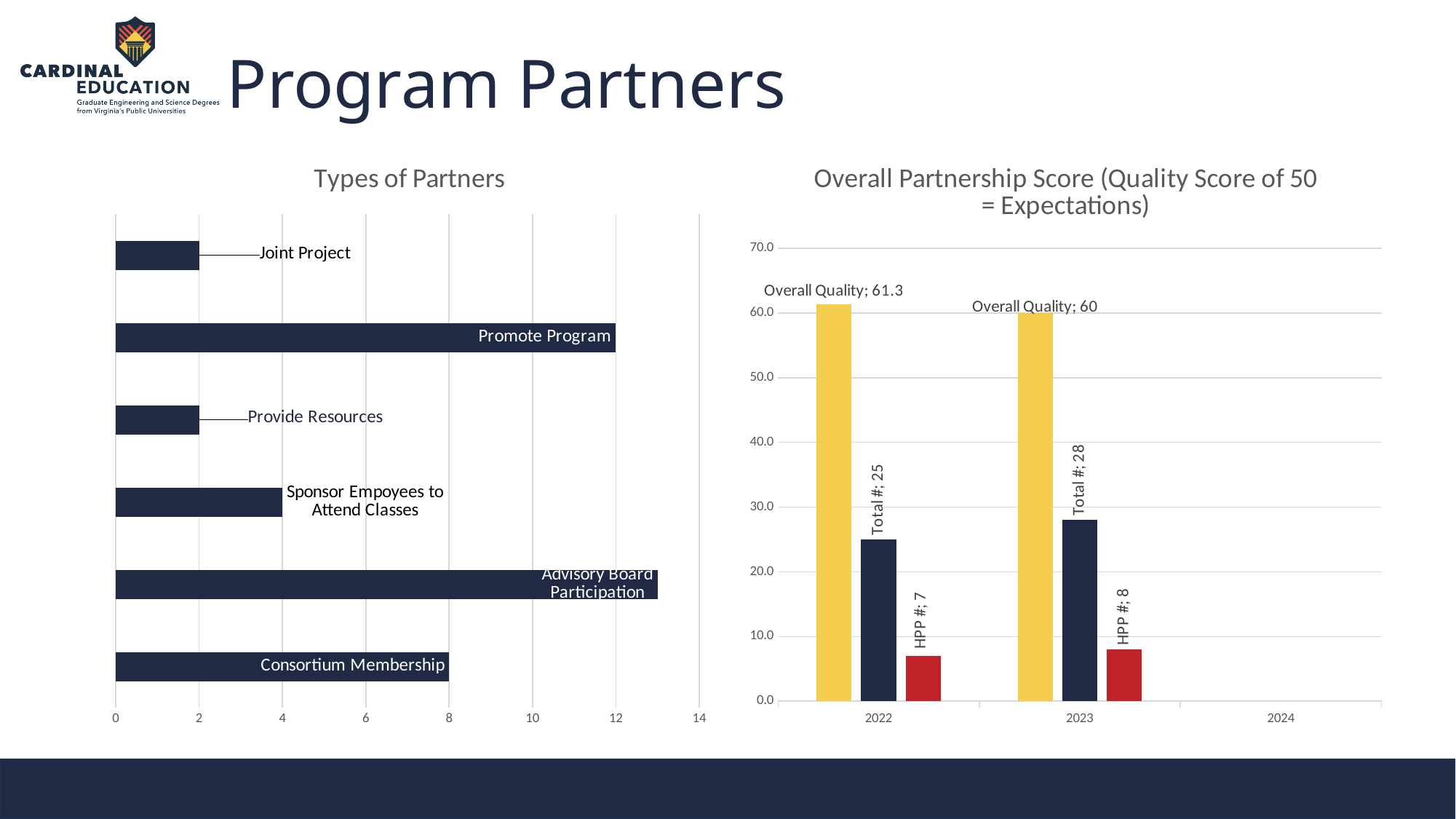
In the "Types of Partners" chart, what is the value for Consortium Membership? 8 In the "Overall Partnership Score" chart, what is the Overall Quality value for 2022? 61.3 In the "Overall Partnership Score" chart, what is the Total # for 2023? 28 In the "Types of Partners" chart, which type of partner has the highest value? Advisory Board Participation In the "Types of Partners" chart, which is larger: Sponsor Employees to Attend Classes or Provide Resources? Sponsor Employees to Attend Classes In the "Overall Partnership Score" chart, does the Overall Quality rise or fall from 2022 to 2023? fall What kind of chart is the "Types of Partners" chart? bar chart In the "Types of Partners" chart, what is the value for Promote Program? 12 In the "Overall Partnership Score" chart, by how much did the Total # increase from 2022 to 2023? 3 In the "Types of Partners" chart, is the value for Advisory Board Participation greater or less than 12? greater How many types of partners are shown in the "Types of Partners" chart? 6 In the "Overall Partnership Score" chart, what is the HPP # for 2022? 7